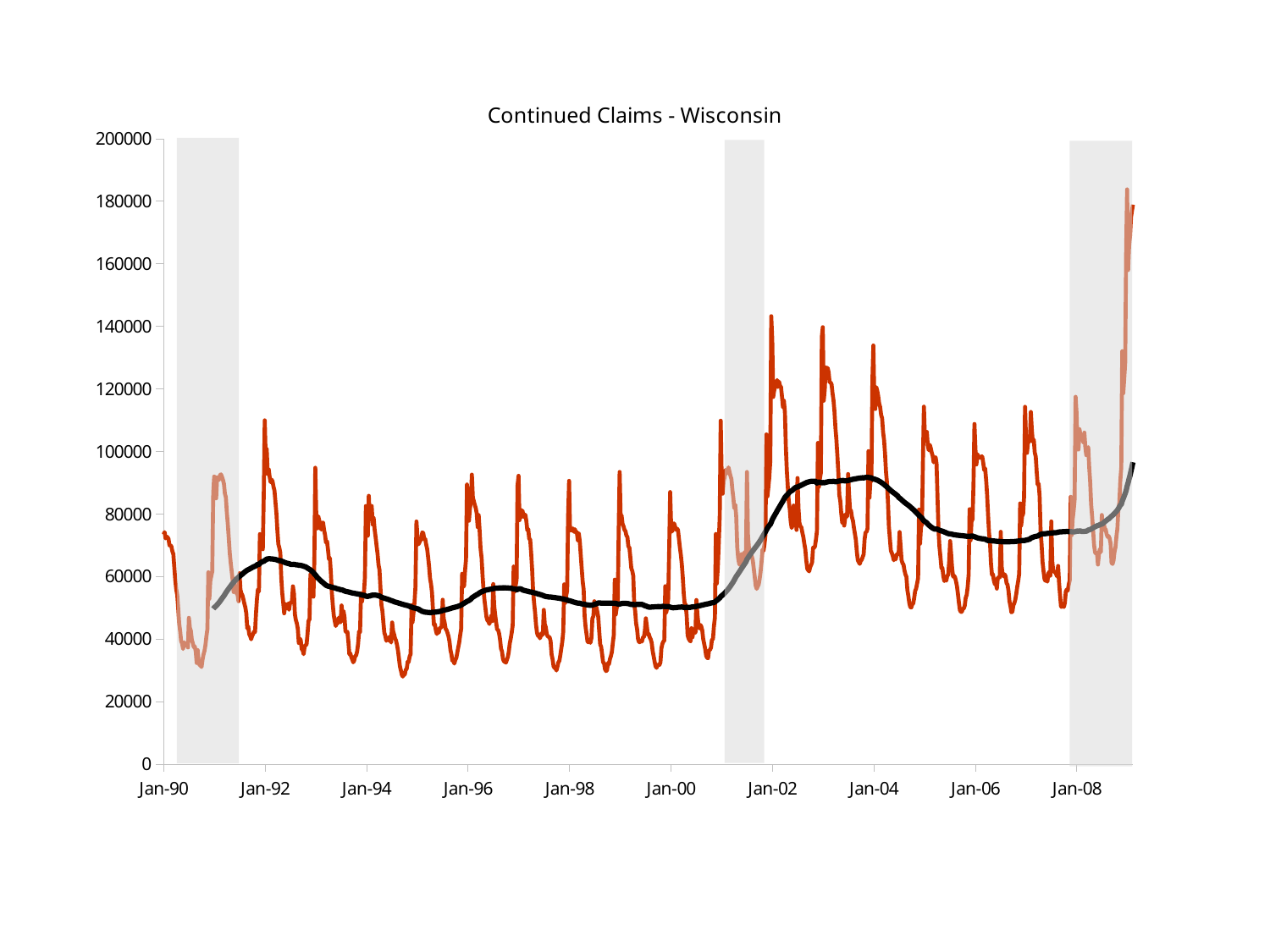
Does the red line reach its highest value before or after Jan-08? after Is the value of the black smoothed line at Jan-04 greater or less than 80000? greater Does the black smoothed line rise or fall between Jan-01 and Jan-03? rise Does the black smoothed line rise or fall between Jan-04 and Jan-06? fall Is the value of the black smoothed line at Jan-98 greater or less than 60000? less Is the peak of the red line just after Jan-02 greater or less than 120000? greater How many date labels are shown on the x axis? 10 How many shaded vertical bands are drawn on the chart? 3 What is the title of the chart? Continued Claims - Wisconsin What kind of chart is shown on the slide? line chart